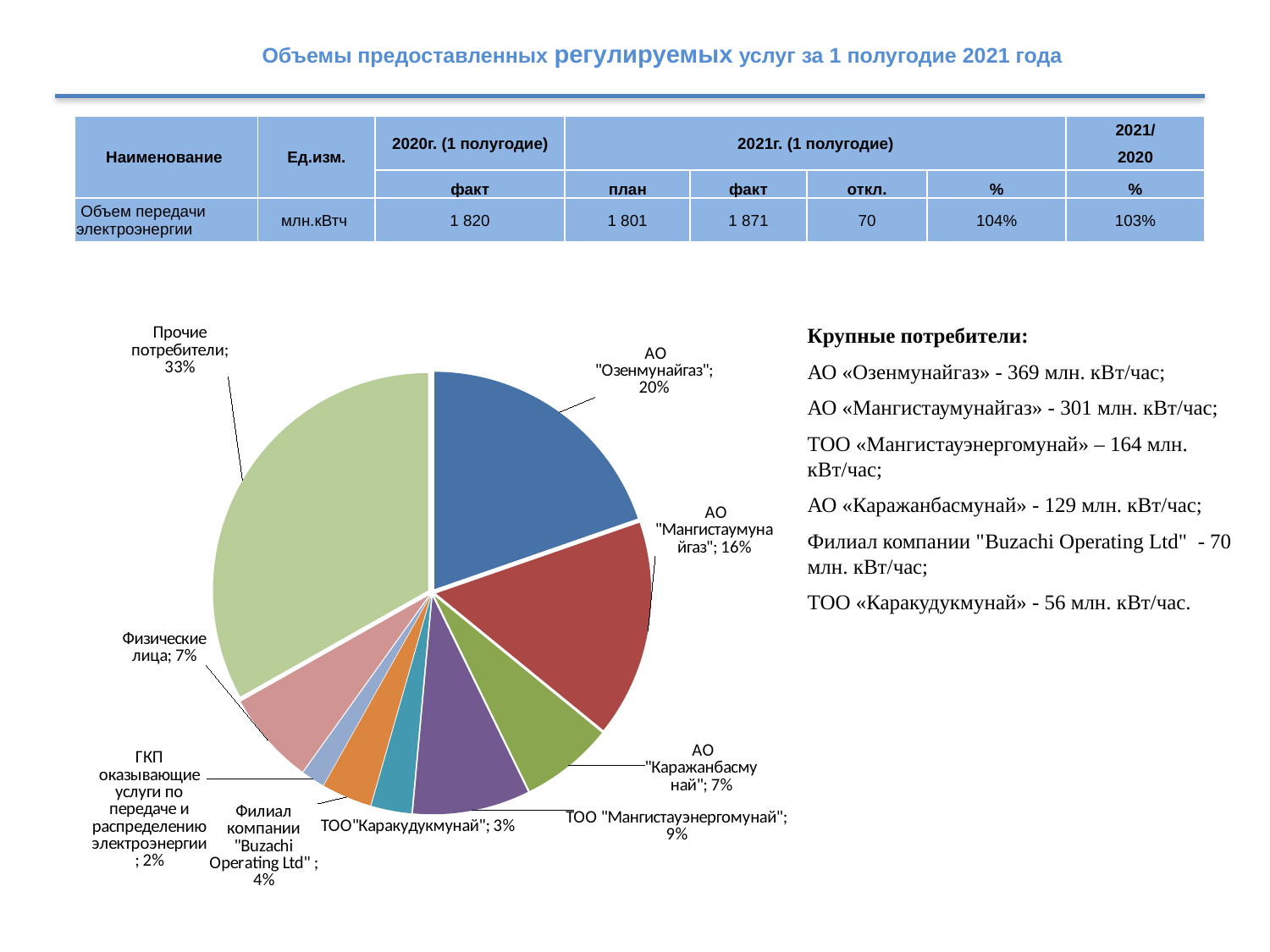
What share of the pie does АО "Озенмунайгаз" have? 20% Which is larger: the share of ТОО "Мангистауэнергомунай" or the share of ТОО "Каракудукмунай"? ТОО "Мангистауэнергомунай" What share of the pie does "Физические лица" have? 7% What kind of chart is shown on the slide? pie chart Which slice of the pie chart is the smallest? ГКП оказывающие услуги по передаче и распределению электроэнергии What share of the pie does АО "Мангистаумунайгаз" have? 16% What is the difference in percentage points between АО "Озенмунайгаз" and АО "Мангистаумунайгаз"? 4 How many slices does the pie chart have? 9 Which slice of the pie chart is the largest? Прочие потребители